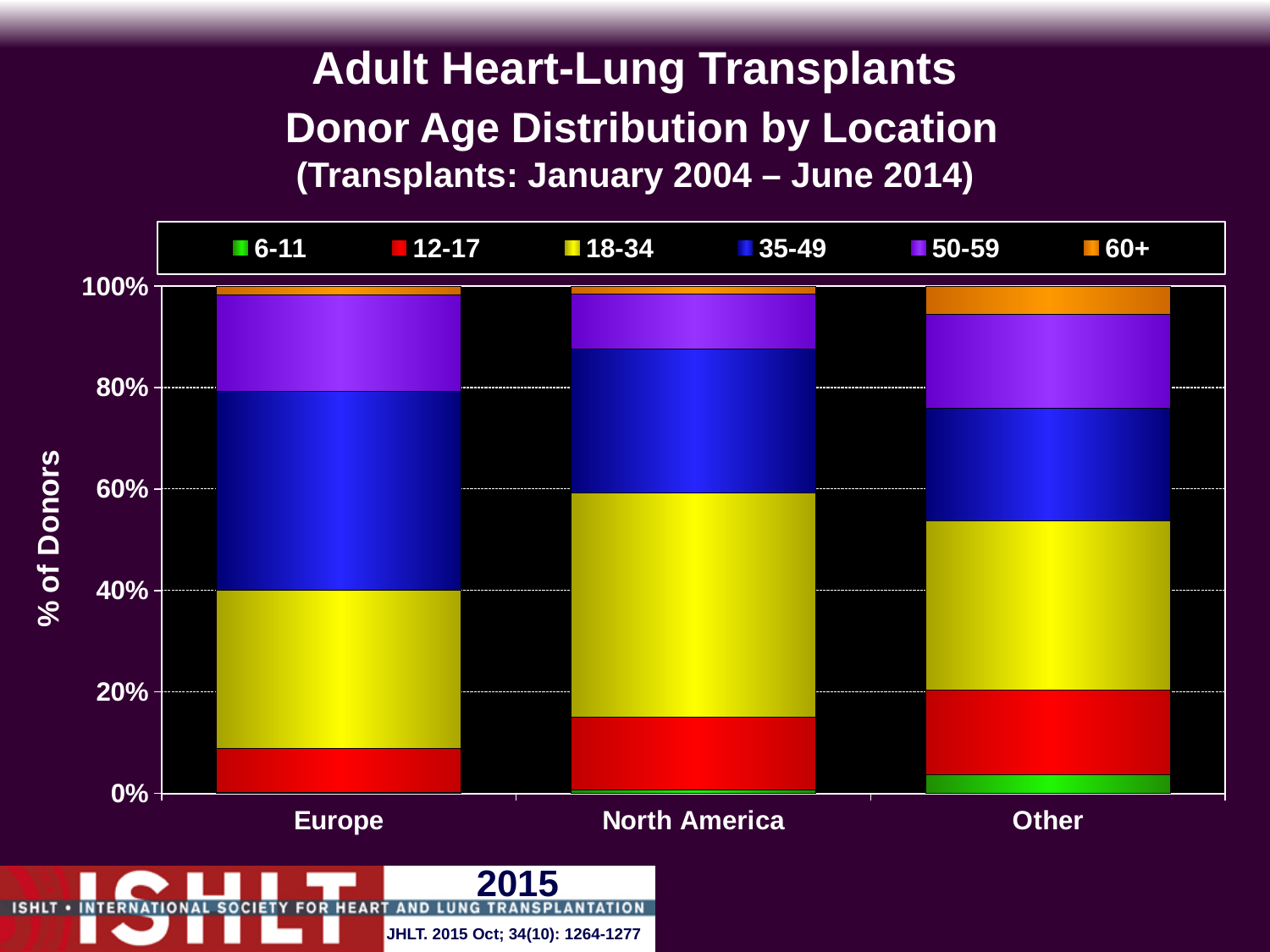
What kind of chart is shown on the slide? Stacked bar chart What transplant period is given in the chart title? January 2004 – June 2014 Which location has the largest 18-34 donor segment? North America How many locations are shown on the x axis of the chart? 3 Which location has the largest 6-11 donor segment? Other Which location has the largest 35-49 donor segment? Europe How many donor age groups does the legend list? 6 Is the 35-49 share of donors for Europe greater or less than 20%? greater Is the 60+ share of donors for Other greater or less than 20%? less Is the 12-17 donor segment larger for Europe or for Other? Other What is the label of the y axis? % of Donors